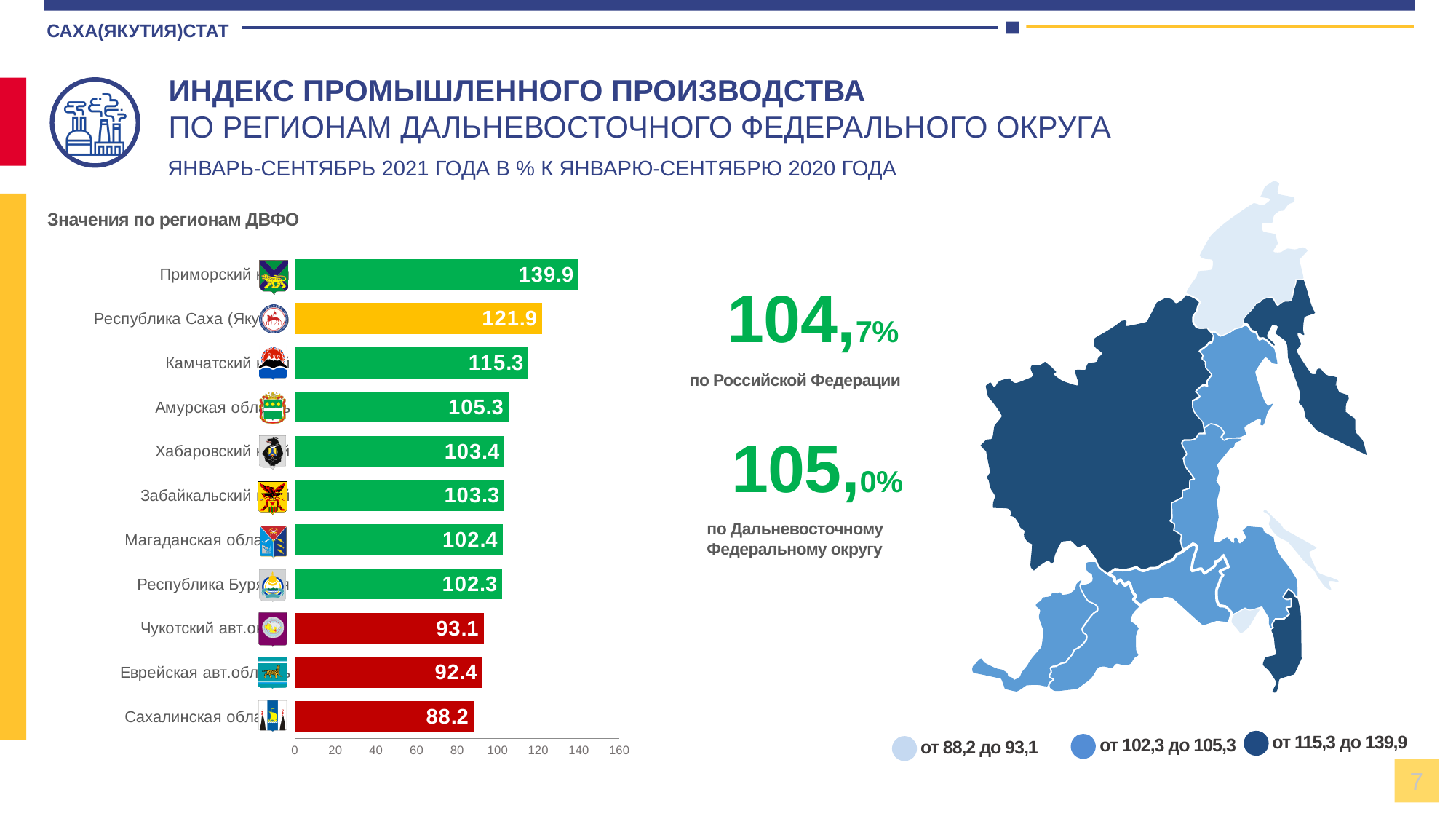
What is the difference between the values for Приморский край and Республика Саха (Якутия)? 18.0 What kind of chart is used to show the values by region? bar chart Which region has the highest value? Приморский край What is the value for Магаданская область? 102.4 Which region has the lowest value? Сахалинская область What is the value for Республика Саха (Якутия)? 121.9 How many regions are shown in the bar chart? 11 What colour is the bar for Республика Саха (Якутия)? yellow What is the value for Приморский край? 139.9 Is the value for Чукотский авт.округ greater or less than 100? less Which is larger, the value for Камчатский край or the value for Амурская область? Камчатский край What is the value for Сахалинская область? 88.2